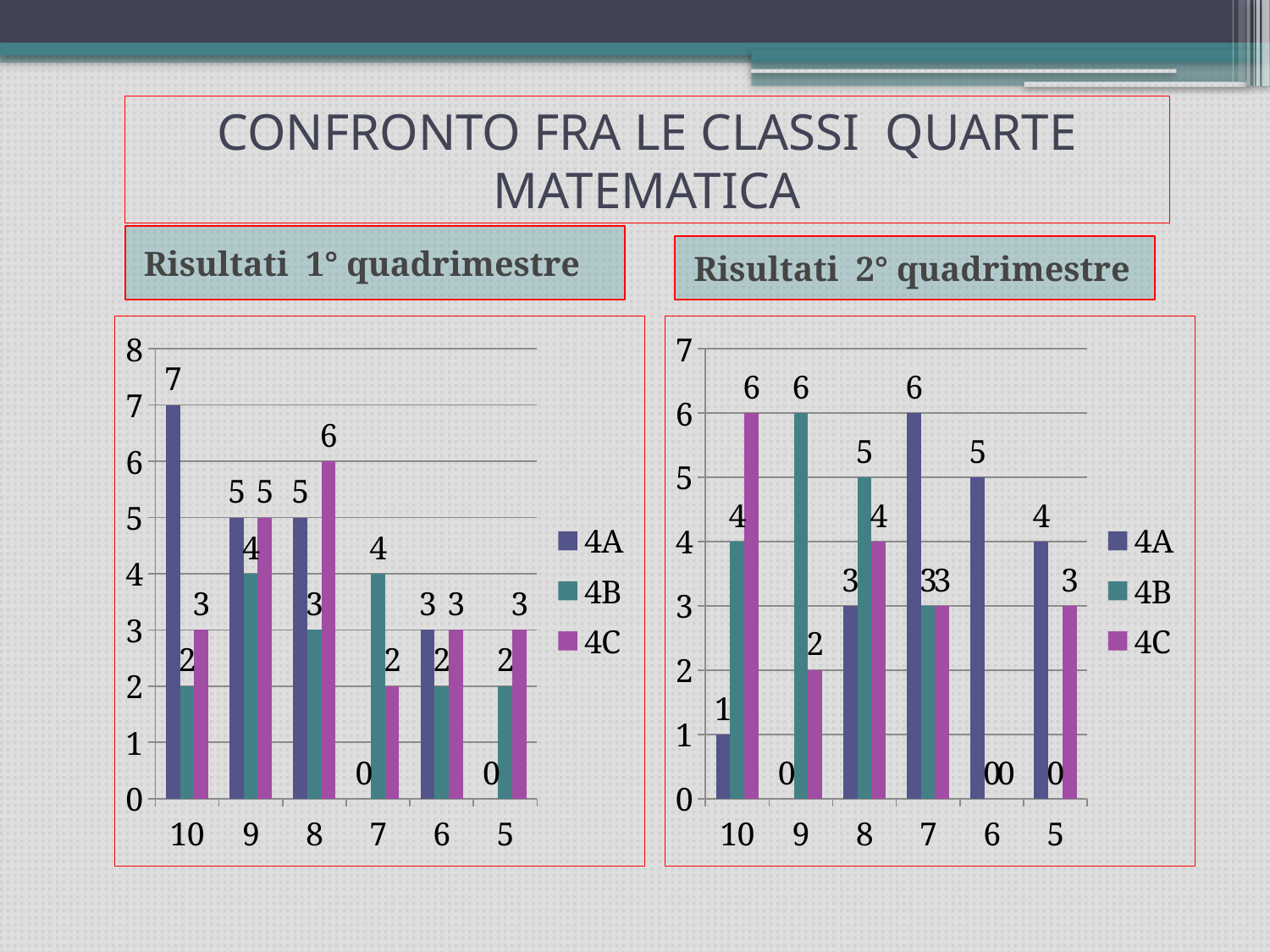
In the 'Risultati 2° quadrimestre' chart, what is the value for 4A at category 7? 6 In the 'Risultati 2° quadrimestre' chart, what is the value for 4B at category 9? 6 In the 'Risultati 2° quadrimestre' chart, what is the difference between the 4C and 4A values at category 10? 5 In the 'Risultati 1° quadrimestre' chart, which is larger at category 7: the value for 4B or the value for 4C? 4B What type of chart is the 'Risultati 2° quadrimestre' chart? Bar chart In the 'Risultati 2° quadrimestre' chart, which category has the lowest value for 4A? 9 How many series does the legend of the 'Risultati 1° quadrimestre' chart list? 3 In the 'Risultati 1° quadrimestre' chart, what is the value for 4A at category 10? 7 How many categories are shown on the x axis of the 'Risultati 2° quadrimestre' chart? 6 In the 'Risultati 1° quadrimestre' chart, what is the difference between the 4A and 4B values at category 10? 5 In the 'Risultati 1° quadrimestre' chart, which category has the highest value for 4A? 10 In the 'Risultati 1° quadrimestre' chart, what is the value for 4C at category 8? 6